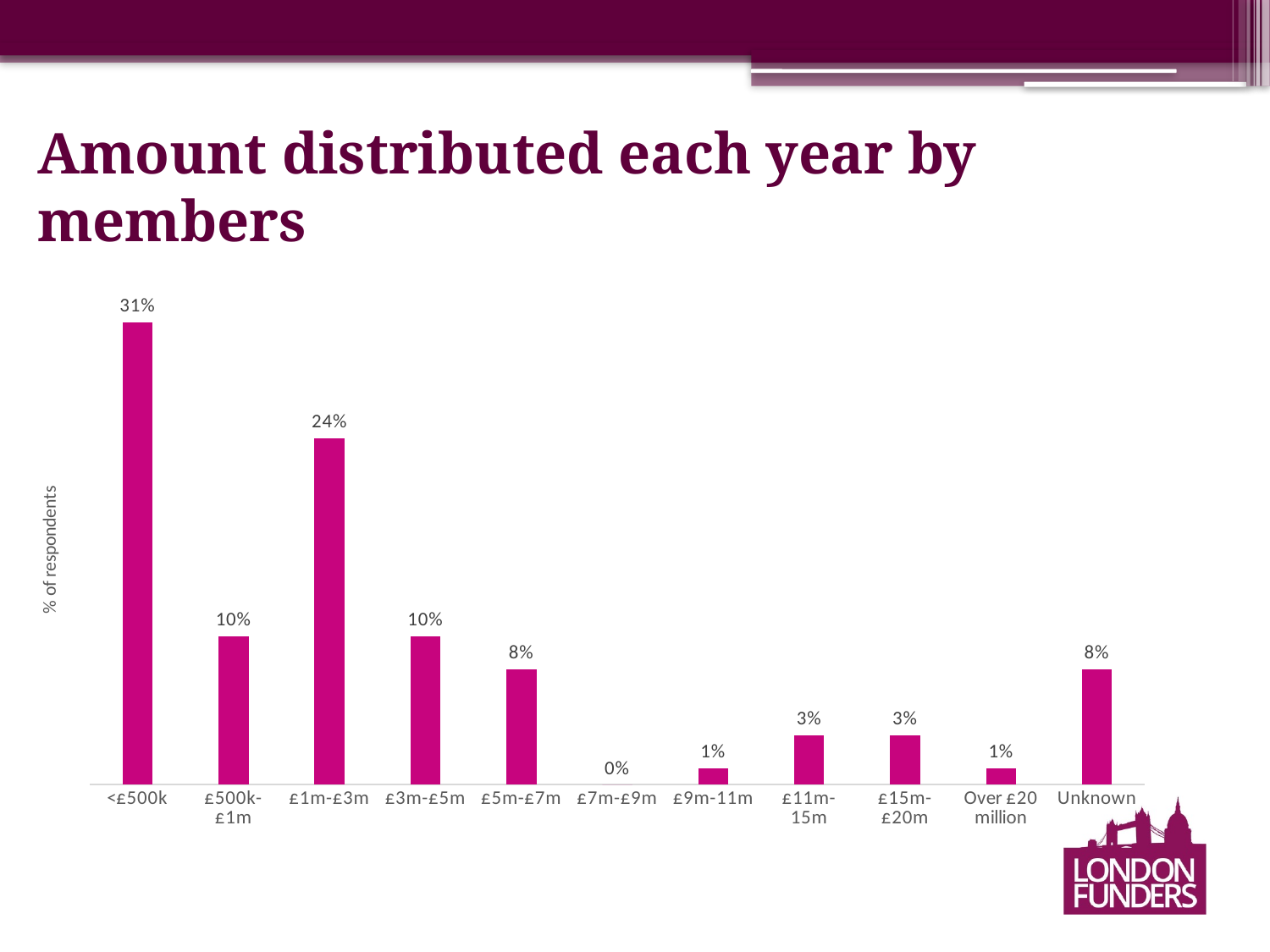
What percentage of respondents distribute less than £500k each year? 31% Which category has the lowest percentage of respondents? £7m-£9m What is the title of the chart? Amount distributed each year by members Which category has the highest percentage of respondents? <£500k What kind of chart is shown on the slide? Bar chart What percentage of respondents fall in the Unknown category? 8% What is the difference between the <£500k and £1m-£3m values? 7% What is the label on the vertical axis? % of respondents Which is larger, the value for £5m-£7m or the value for £11m-15m? £5m-£7m What is the value for the £1m-£3m category? 24% What is the value for the £7m-£9m category? 0% How many categories are shown on the x axis? 11